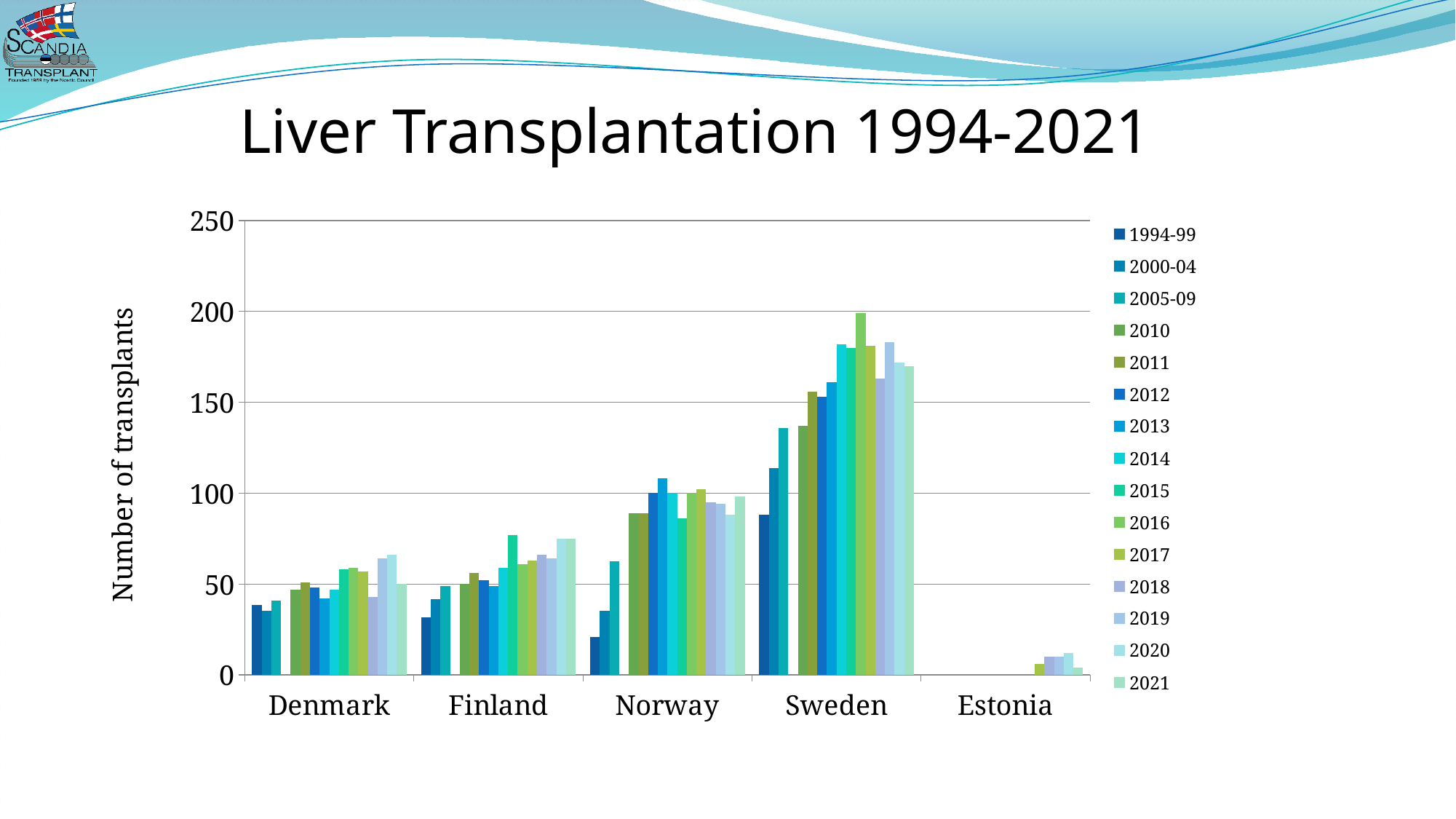
Is the value for Sweden in 1994-99 greater or less than 100? less Which country has the lowest number of liver transplants in the chart? Estonia How many series does the legend list? 15 What kind of chart is shown on the slide? Bar chart How many countries are shown on the x axis of the chart? 5 Which is larger, the 2016 value for Sweden or the 2016 value for Norway? Sweden Which is larger, the 2005-09 value for Norway or the 2005-09 value for Sweden? Sweden Is the value for Finland in 2021 greater or less than 50? greater What is the label on the vertical axis of the chart? Number of transplants Is the value for Denmark in 1994-99 greater or less than 50? less Which country has the highest number of liver transplants in the chart? Sweden